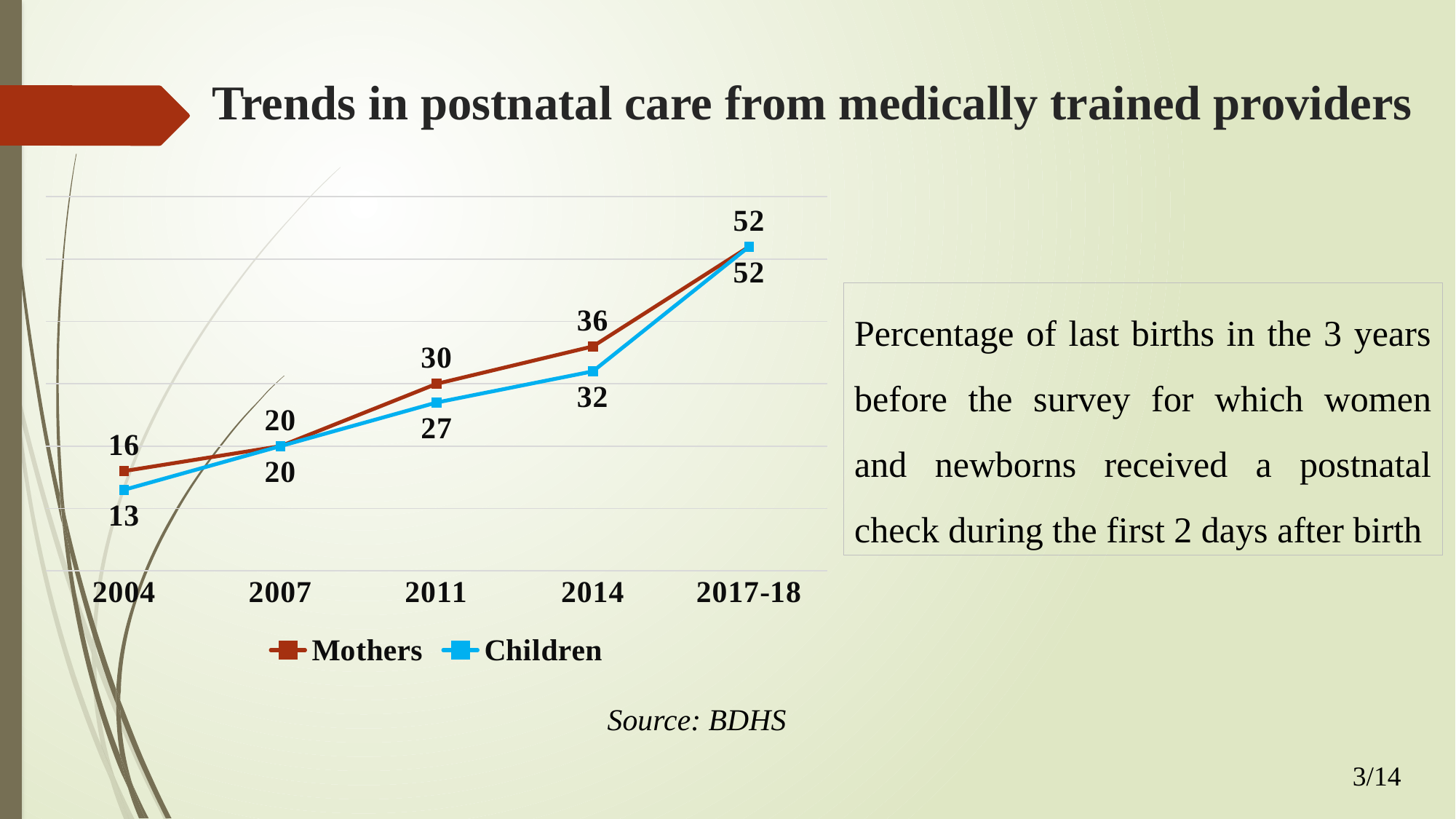
What is the value for Children in 2004? 13 What is the difference between the Mothers and Children values in 2014? 4 What kind of chart is shown on the slide? Line chart Do the values for Children rise or fall from 2004 to 2017-18? Rise How many years are shown on the x axis? 5 Which is larger in 2011, the value for Mothers or for Children? Mothers What is the value for Children in 2011? 27 What is the source cited below the chart? BDHS How many series does the legend list? 2 In which year is the Children series lowest? 2004 What is the value for Mothers in 2014? 36 In which year is the Mothers series highest? 2017-18